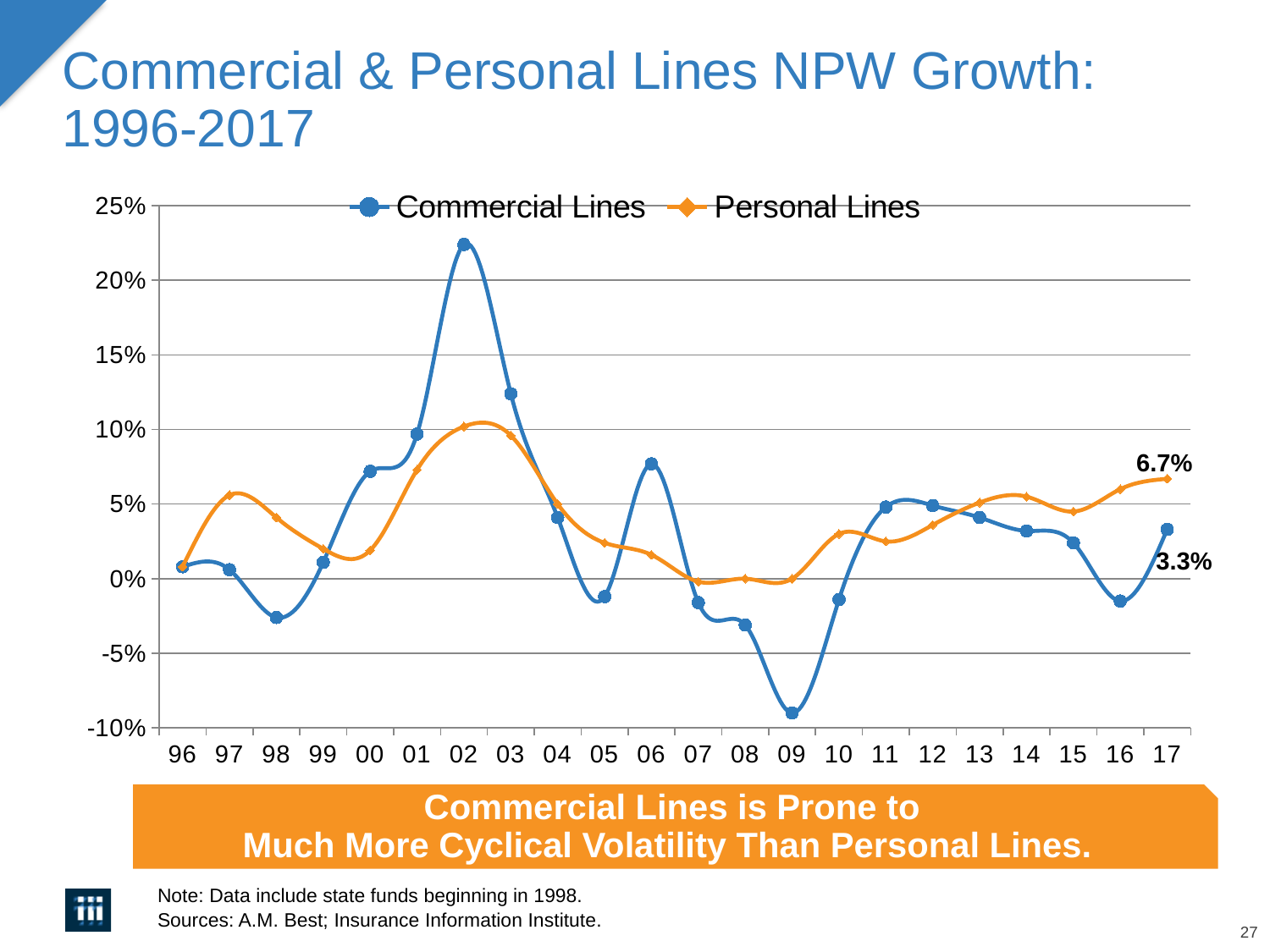
In 17, how much higher is the Personal Lines value than the Commercial Lines value? 3.4 percentage points Is the Commercial Lines value for 09 greater or less than -5%? less In 17, which series has the larger value, Commercial Lines or Personal Lines? Personal Lines In which year does the Commercial Lines series reach its lowest value? 09 How many series does the chart's legend list? 2 Is the Commercial Lines value for 02 greater or less than 20%? greater What kind of chart is shown on the slide? Line chart What is the Commercial Lines NPW growth value shown for 17? 3.3% In which year does the Commercial Lines series reach its highest value? 02 What is the Personal Lines NPW growth value shown for 17? 6.7% How many years are shown on the x axis of the chart? 22 In 09, which series has the larger value, Commercial Lines or Personal Lines? Personal Lines